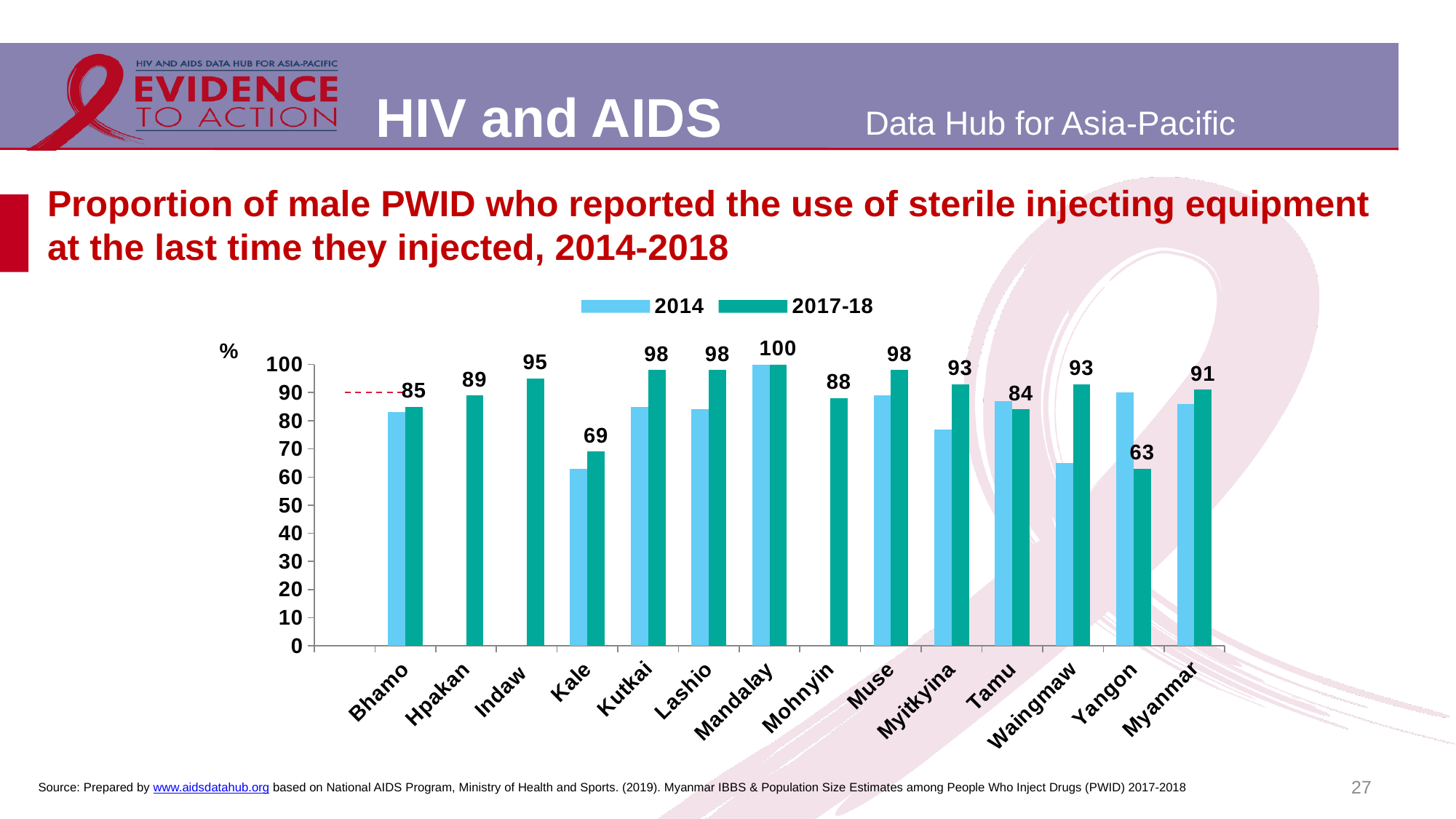
How many series does the legend list? 2 For Yangon, which series has the larger value, 2014 or 2017-18? 2014 What is the 2017-18 value for Myanmar? 91 Which has a higher 2017-18 value, Indaw or Hpakan? Indaw What is the difference between the 2017-18 values for Mandalay and Yangon? 37 What is the 2017-18 value for Mohnyin? 88 How many categories are shown on the x axis? 14 Is the 2014 value for Waingmaw greater or less than 70? less Which category has the highest 2017-18 value? Mandalay What is the 2017-18 value for Kale? 69 Which category has the lowest 2017-18 value? Yangon What kind of chart is shown on the slide? bar chart